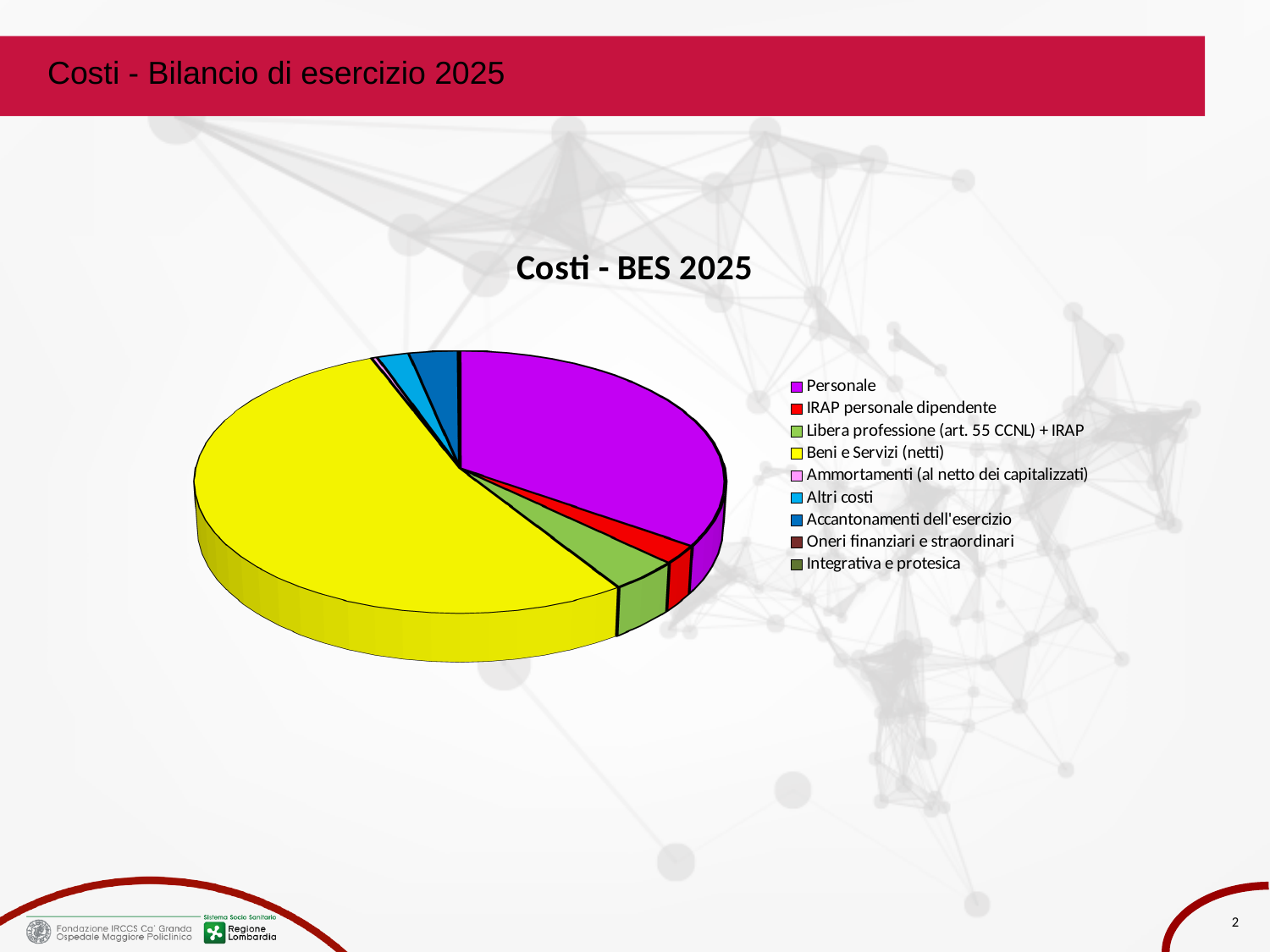
What kind of chart is shown on the slide? pie chart Which slice is larger, Personale or Beni e Servizi (netti)? Beni e Servizi (netti) What colour is the Personale slice in the pie chart? purple What is the title of the chart? Costi - BES 2025 How many entries does the chart legend list? 9 Which slice is larger, Beni e Servizi (netti) or Altri costi? Beni e Servizi (netti) Which slice is larger, Personale or IRAP personale dipendente? Personale Which category has the largest slice of the pie? Beni e Servizi (netti)